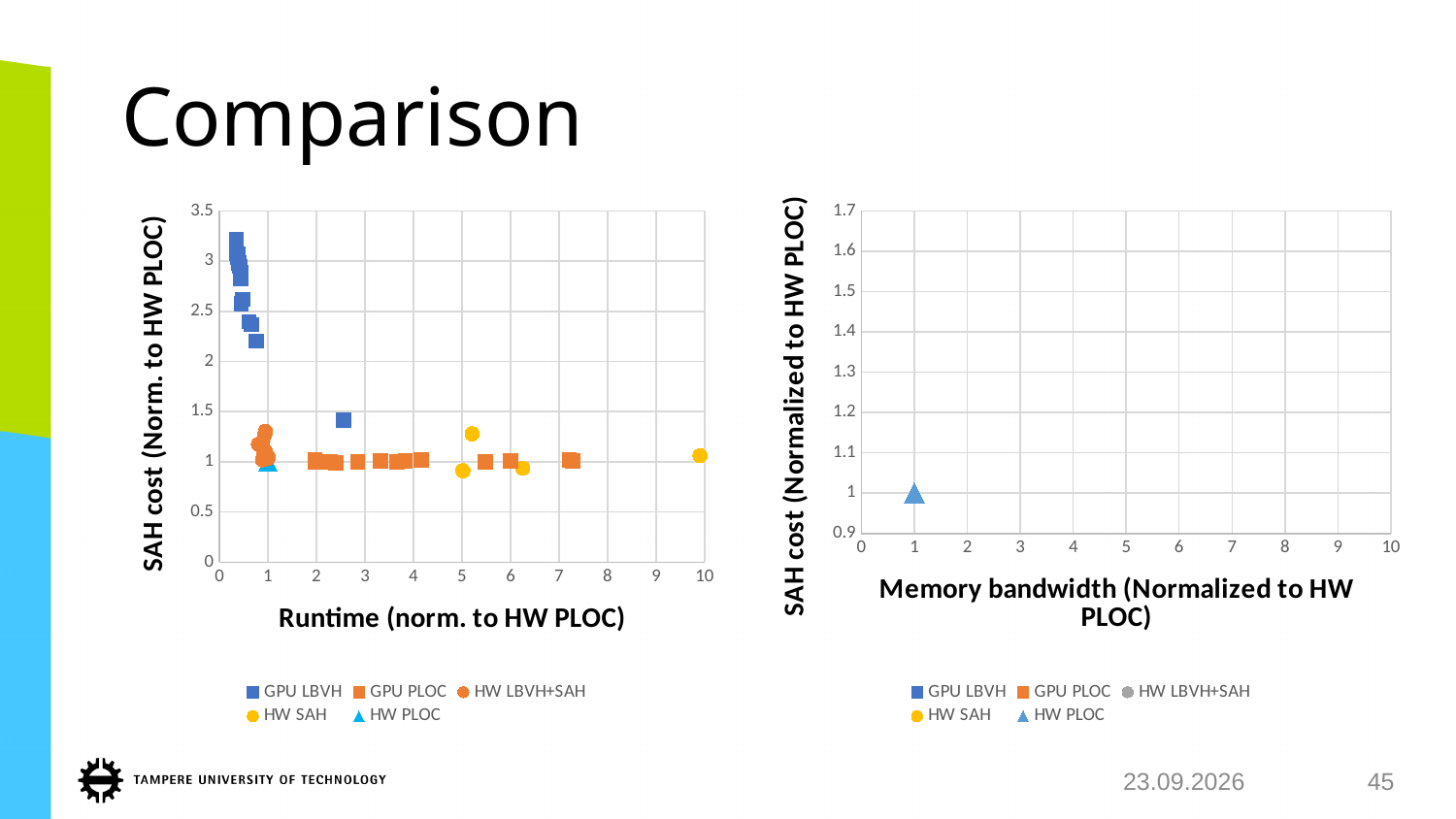
What is the x-axis title of the left chart? Runtime (norm. to HW PLOC) In the left chart, is the SAH cost of the highest GPU LBVH point greater or less than 3? greater What kind of chart is the left chart (Runtime vs SAH cost)? scatter chart In the left chart, do the SAH cost values of the GPU LBVH points rise or fall as runtime increases? fall In the left chart, is the runtime of the rightmost HW SAH point greater or less than 9? greater How many series does the legend of the right chart list? 5 What is the x-axis title of the right chart? Memory bandwidth (Normalized to HW PLOC) In the left chart, which series contains the point with the largest runtime? HW SAH In the left chart, which series has the highest SAH cost values? GPU LBVH In the right chart, what is the SAH cost value of the HW PLOC point? 1 In the right chart, what is the memory bandwidth value of the HW PLOC point? 1 How many series does the legend of the left chart list? 5